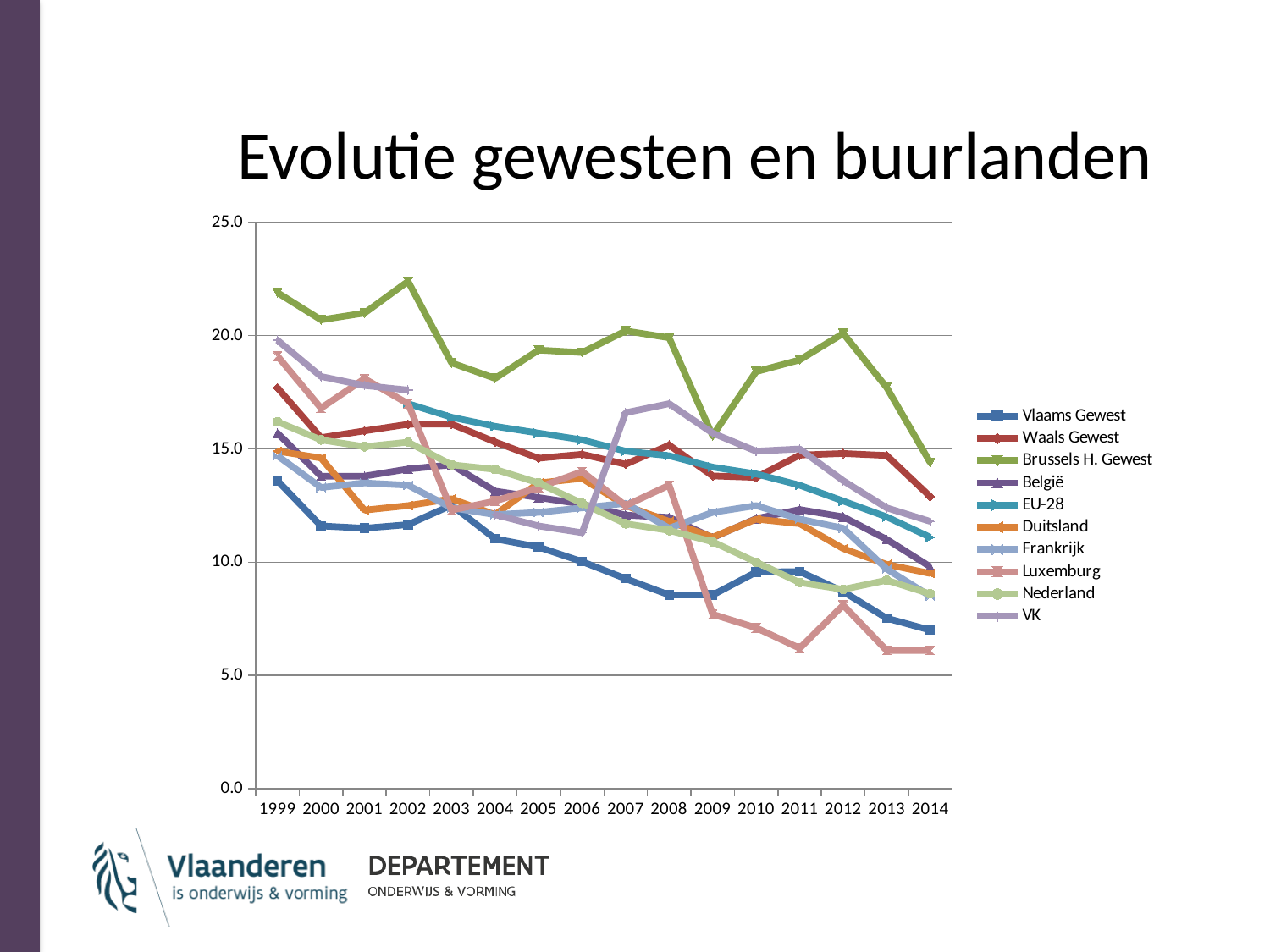
Is the value for Brussels H. Gewest in 1999 greater or less than 20.0? greater Is the value for Vlaams Gewest in 2014 greater or less than 10.0? less What kind of chart is shown on the slide? line chart How many years are shown on the x axis? 16 What is the title of the chart? Evolutie gewesten en buurlanden How many series does the legend list? 10 In 2014, which is higher: Waals Gewest or Vlaams Gewest? Waals Gewest Is the value for EU-28 in 2002 greater or less than 15.0? greater Which series has the highest value in 1999? Brussels H. Gewest Which series has the lowest value in 1999? Vlaams Gewest Does the Vlaams Gewest line rise or fall overall from 1999 to 2014? fall Which series has the lowest value in 2014? Luxemburg